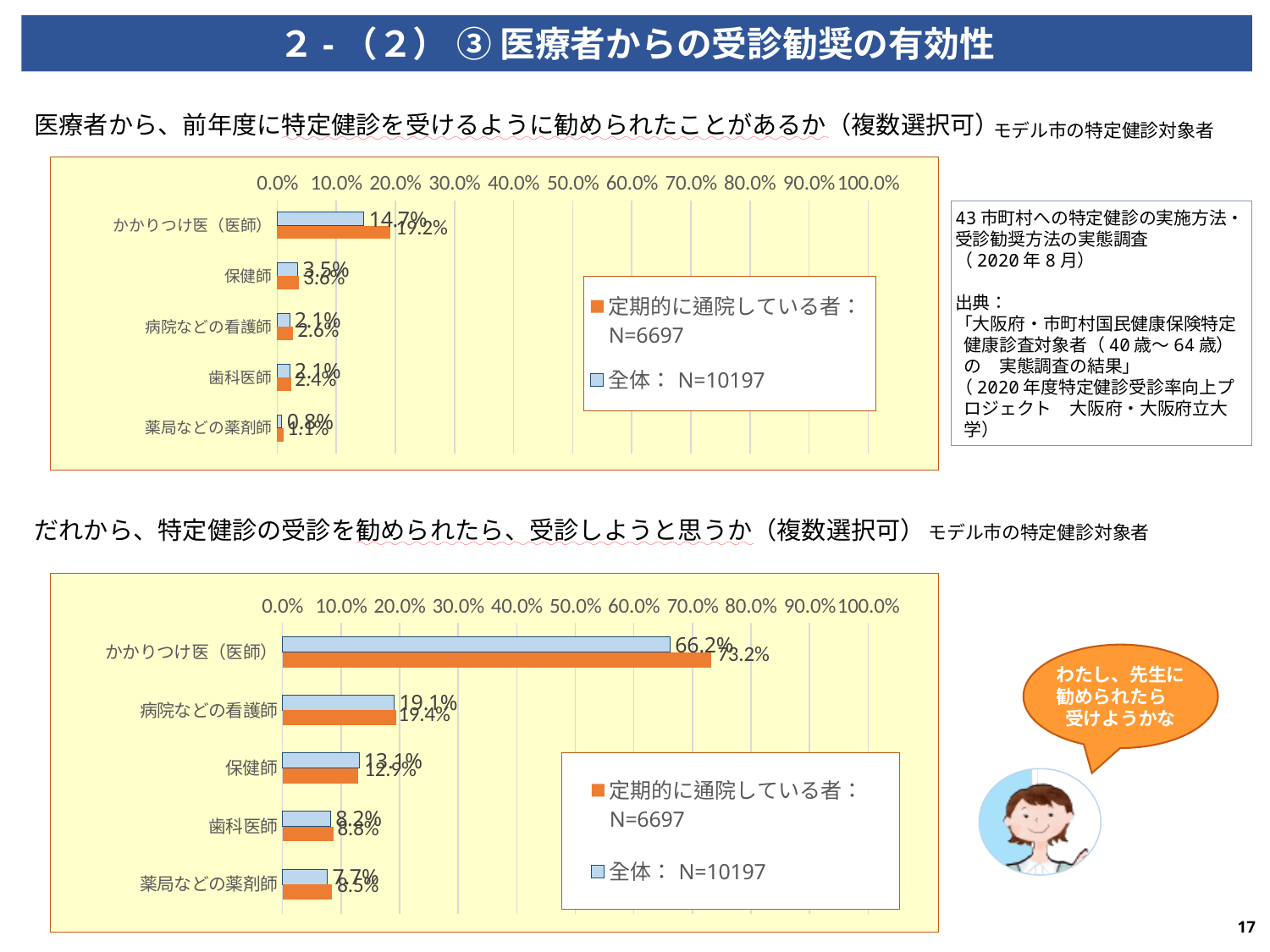
In the bottom chart, what is the difference between the 定期的に通院している者 value and the 全体 value for かかりつけ医（医師）? 7.0% In the bottom chart, how many series does the legend list? 2 In the bottom chart, what is the N shown in the legend for the 全体 series? N=10197 In the bottom chart, what is the value for かかりつけ医（医師） for the 定期的に通院している者 series? 73.2% In the bottom chart, which category has the highest value for the 全体 series? かかりつけ医（医師） In the top chart, what is the value for かかりつけ医（医師） for the 全体 series? 14.7% In the bottom chart, what is the value for 病院などの看護師 for the 全体 series? 19.1% In the top chart, what is the value for かかりつけ医（医師） for the 定期的に通院している者 series? 19.2% In the top chart, how many categories are shown on the vertical axis? 5 In the bottom chart, is the 定期的に通院している者 value for かかりつけ医（医師） greater or less than 70.0%? greater In the top chart, which category has the lowest value for the 全体 series? 薬局などの薬剤師 What kind of chart is the top chart (医療者から、前年度に特定健診を受けるように勧められたことがあるか)? Bar chart